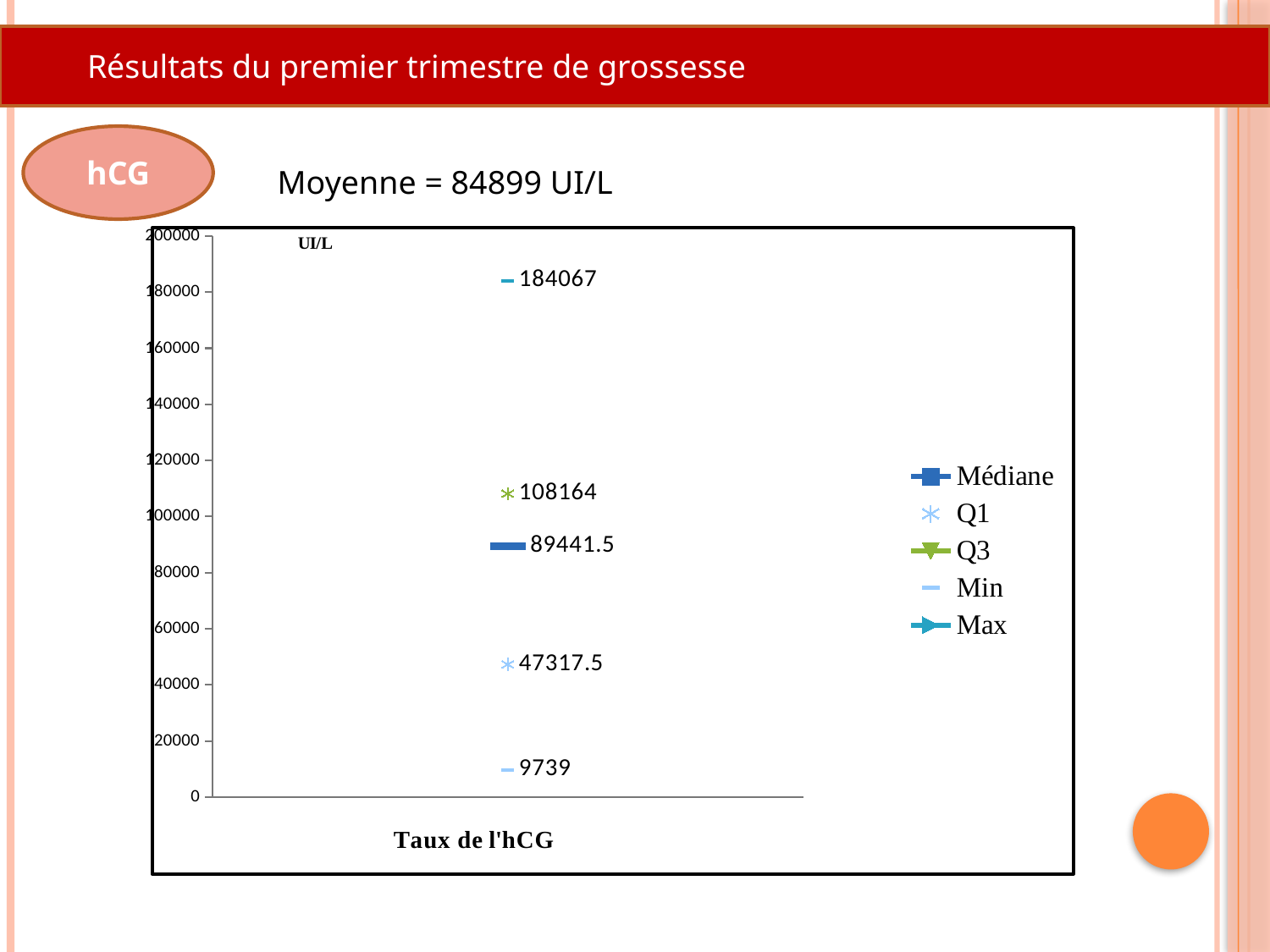
What is the value of the Q1 series for Taux de l'hCG? 47317.5 Which series has the lowest plotted value? Min What is the label on the x axis of the chart? Taux de l'hCG Which series has the highest plotted value? Max What is the difference between the Max value and the Min value? 174328 What is the value of the Q3 series for Taux de l'hCG? 108164 How many series does the legend list? 5 What is the difference between the Q3 value and the Q1 value? 60846.5 What is the value of the Max series for Taux de l'hCG? 184067 What is the value of the Médiane series for Taux de l'hCG? 89441.5 Which is larger, the Médiane value or the Q3 value? Q3 What is the value of the Min series for Taux de l'hCG? 9739